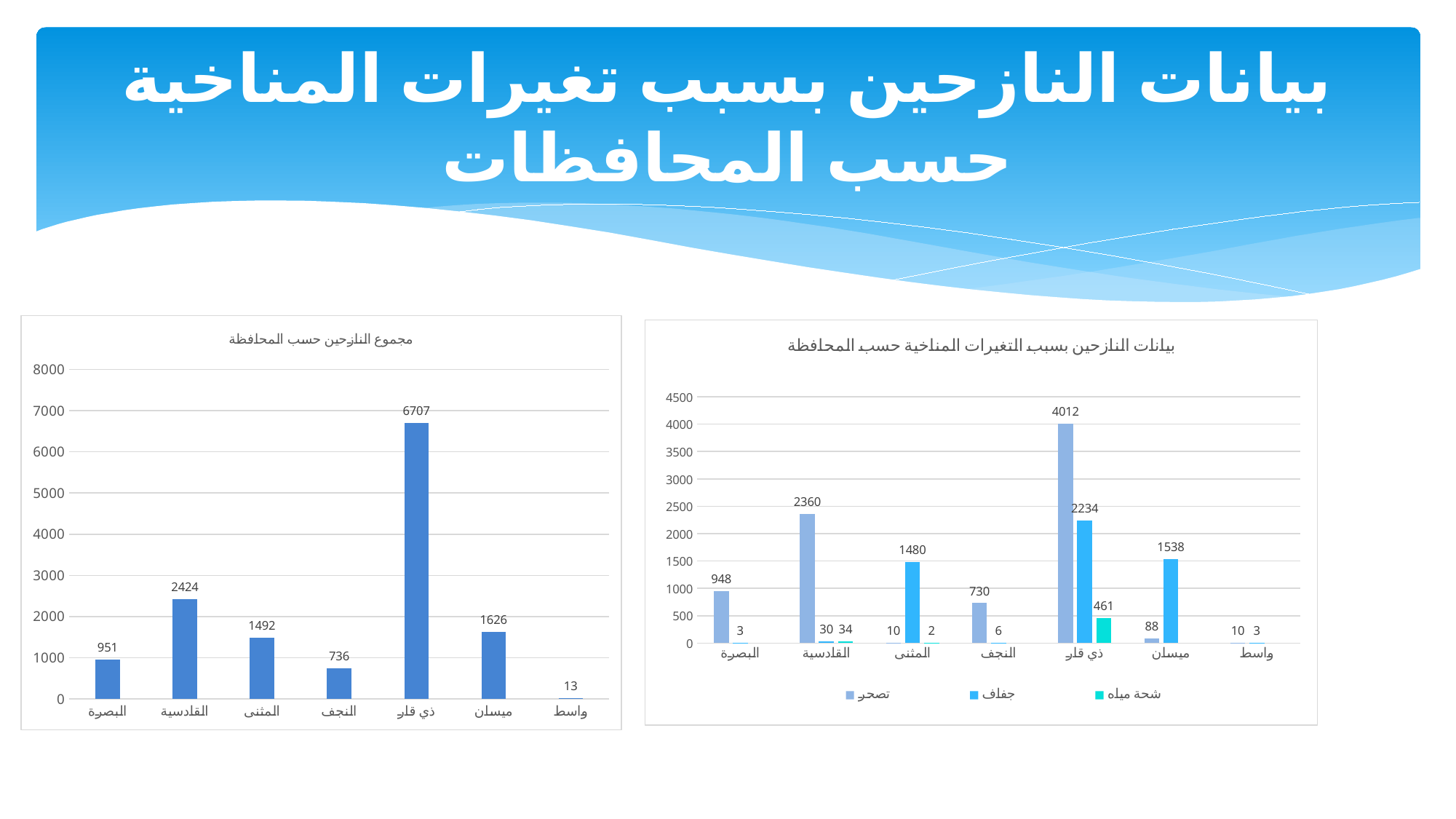
In the right chart (بيانات النازحين بسبب التغيرات المناخية حسب المحافظة), how many series does the legend list? 3 In the left chart (مجموع النازحين حسب المحافظة), which governorate has the lowest value? واسط In the right chart (بيانات النازحين بسبب التغيرات المناخية حسب المحافظة), what is the value of جفاف for ميسان? 1538 In the left chart (مجموع النازحين حسب المحافظة), which is larger, ميسان or المثنى? ميسان In the right chart (بيانات النازحين بسبب التغيرات المناخية حسب المحافظة), what is the value of تصحر for ذي قار? 4012 In the right chart (بيانات النازحين بسبب التغيرات المناخية حسب المحافظة), what is the difference between تصحر and جفاف for ذي قار? 1778 In the right chart (بيانات النازحين بسبب التغيرات المناخية حسب المحافظة), which governorate has the highest جفاف value? ذي قار In the right chart (بيانات النازحين بسبب التغيرات المناخية حسب المحافظة), which series is shown in the legend with the cyan colour? شحة مياه In the left chart (مجموع النازحين حسب المحافظة), what is the value for ذي قار? 6707 In the left chart (مجموع النازحين حسب المحافظة), how many governorates are shown on the x axis? 7 What kind of chart is the left chart (مجموع النازحين حسب المحافظة)? bar chart In the left chart (مجموع النازحين حسب المحافظة), what is the difference between القادسية and البصرة? 1473